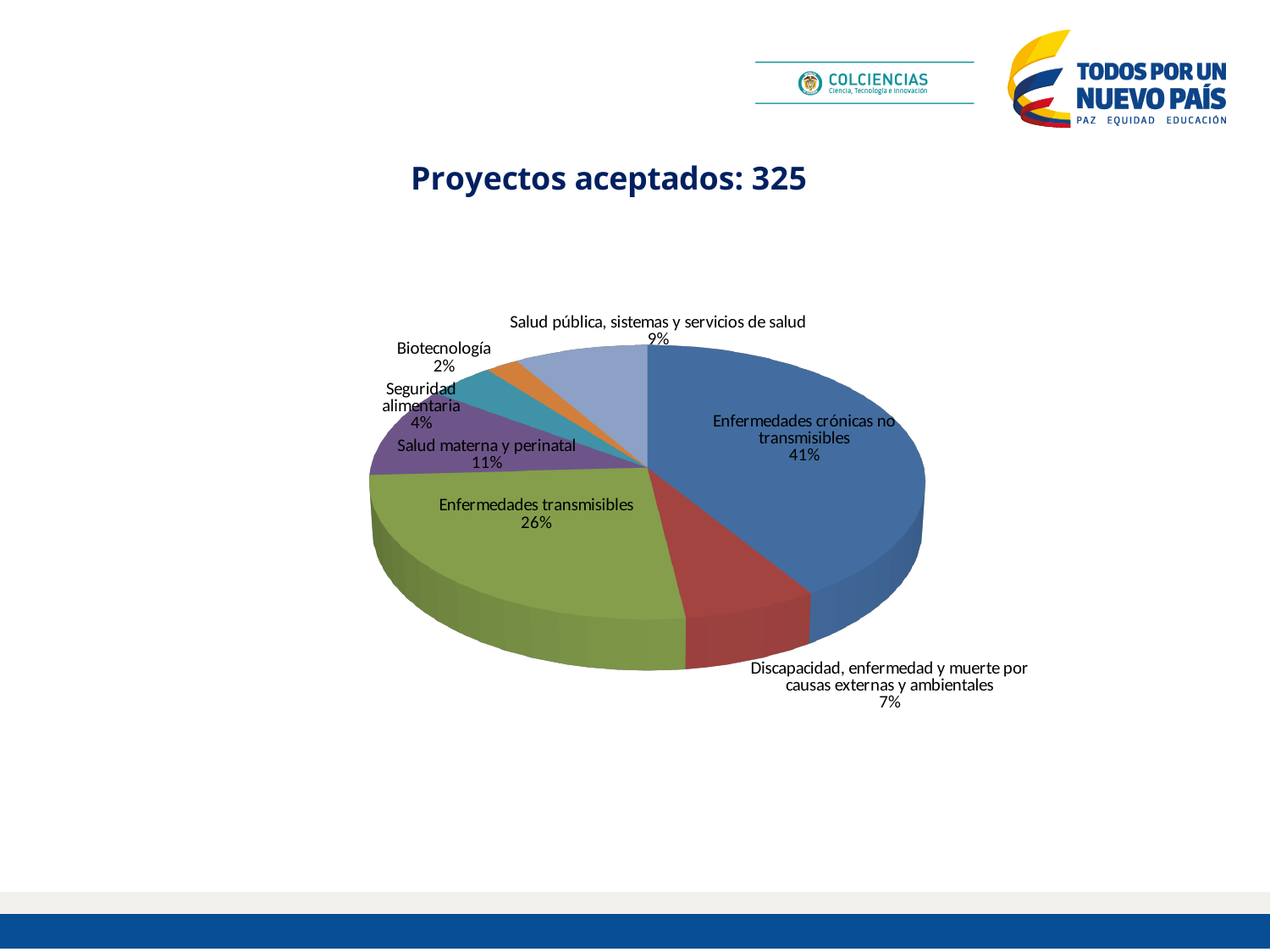
What is the value shown for Enfermedades transmisibles? 26% What is the value shown for Salud pública, sistemas y servicios de salud? 9% Which category has the largest share of the pie? Enfermedades crónicas no transmisibles What kind of chart is shown on the slide? pie chart What is the difference in percentage points between Enfermedades crónicas no transmisibles and Enfermedades transmisibles? 15 What is the value shown for Discapacidad, enfermedad y muerte por causas externas y ambientales? 7% What is the value shown for Salud materna y perinatal? 11% Which is larger, the share for Seguridad alimentaria or the share for Biotecnología? Seguridad alimentaria What is the title shown above the chart? Proyectos aceptados: 325 How many categories are shown in the pie chart? 7 Which category has the smallest share of the pie? Biotecnología What share of the pie does Enfermedades crónicas no transmisibles represent? 41%